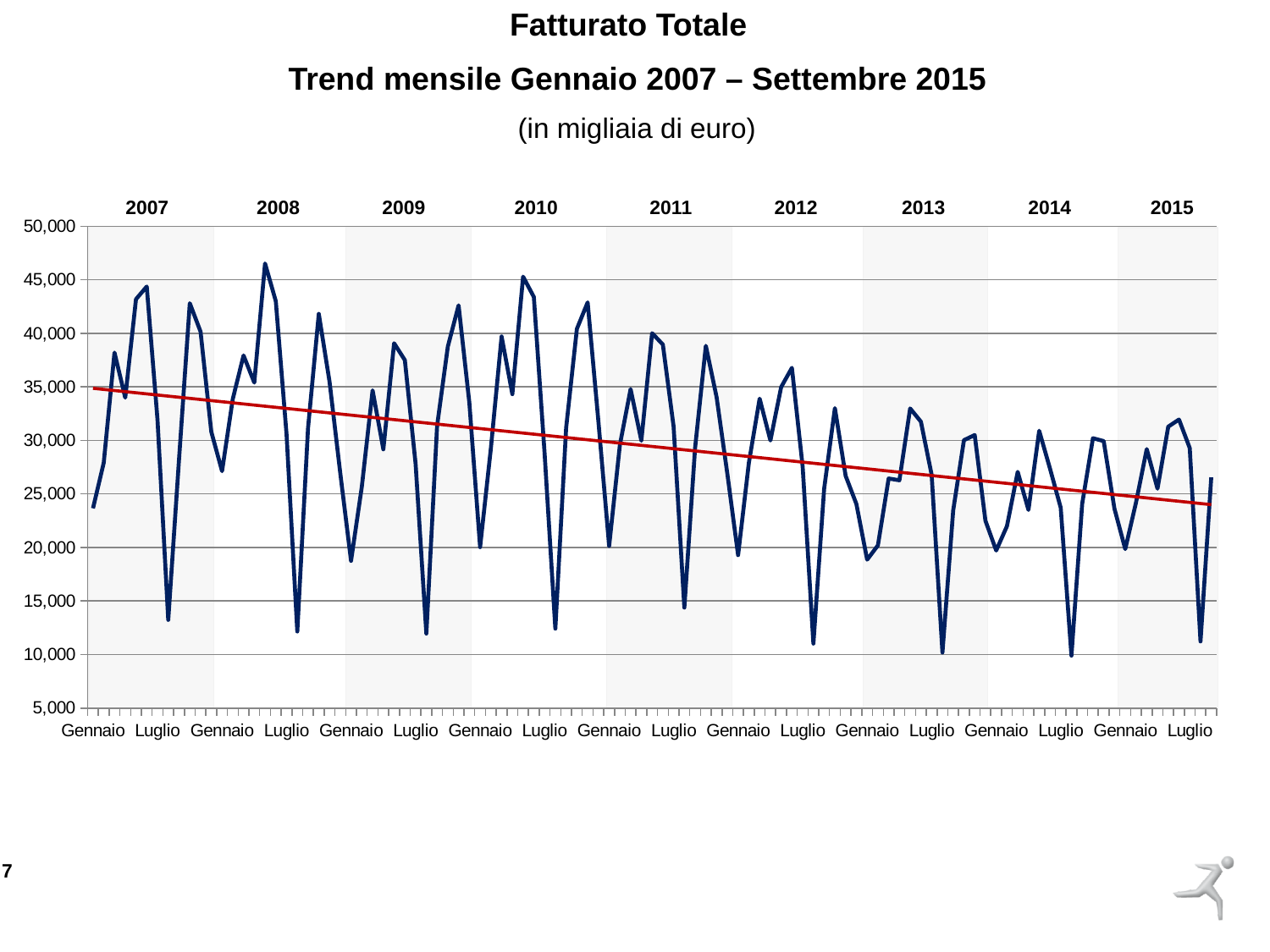
Is the lowest point in 2014 greater or less than 15,000? less Does the red trend line rise or fall from left to right across the chart? fall What is the title of the chart? Fatturato Totale In what units are the values on the chart expressed? migliaia di euro How many years are labelled along the top of the chart? 9 Is the red trend line at the end of 2015 greater or less than 30,000? less What kind of chart is shown on the slide? line chart Is the highest peak in 2008 greater or less than 40,000? greater In which year does the chart reach its highest point? 2008 Is the highest peak in 2008 higher or lower than the highest peak in 2015? higher